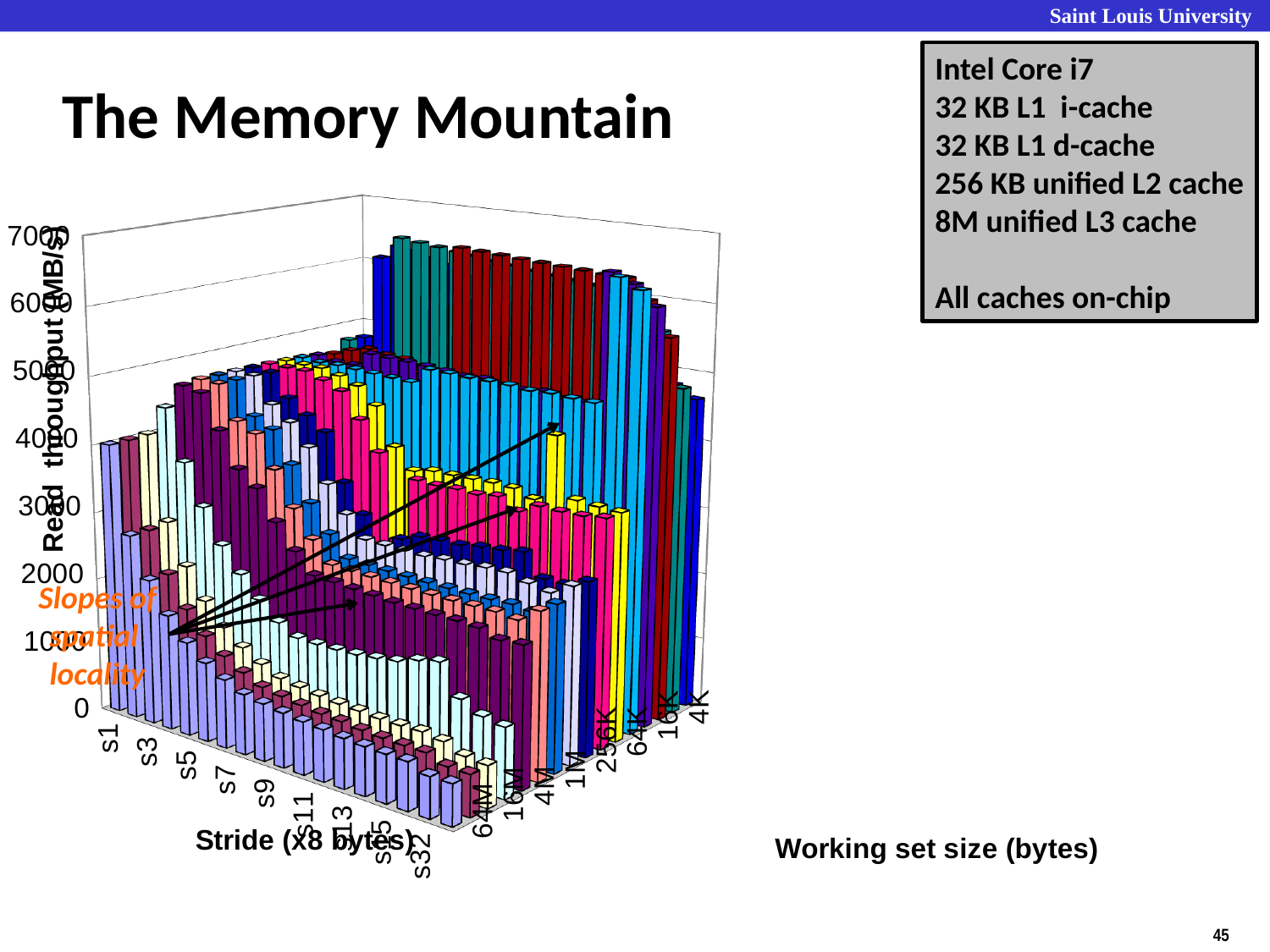
How many stride labels are shown along the stride axis of the chart? 9 How many working set size labels are shown along the working set size axis of the chart? 8 What is the label of the vertical axis of the chart? Read throughput (MB/s) For a fixed working set size, does read throughput generally rise or fall as the stride increases from s1 to s32? fall What is the highest tick value shown on the vertical axis of the chart? 7000 What is the title of the chart on the slide? The Memory Mountain What is the largest working set size label shown on the chart? 64M What is the smallest working set size label shown on the chart? 4K What is the largest stride label shown on the stride axis? s32 What is the smallest stride label shown on the stride axis? s1 For a fixed stride, does read throughput generally rise or fall as the working set size decreases from 64M to 4K? rise What kind of chart is shown on the slide? 3D bar chart